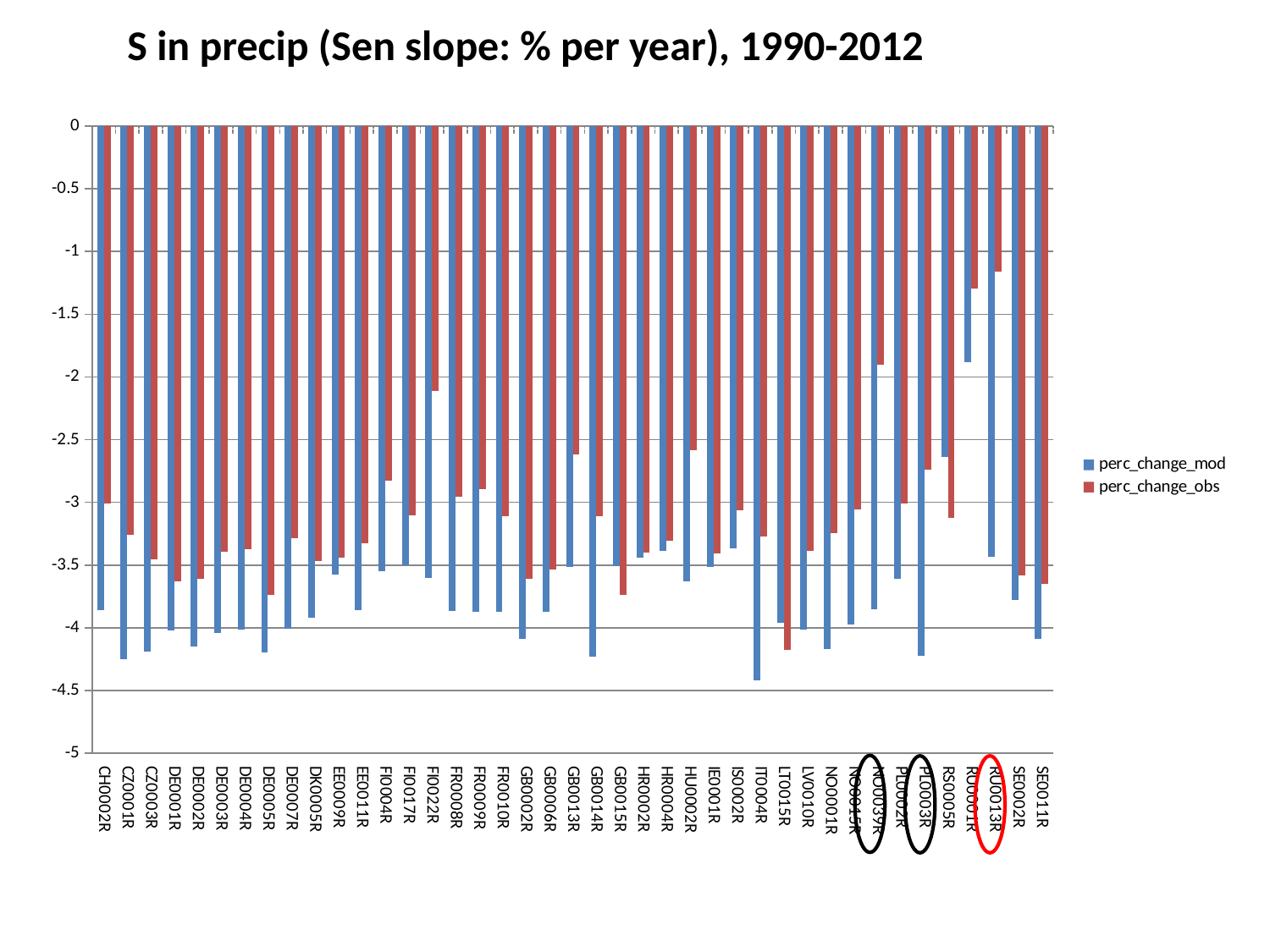
Is the perc_change_mod value for IT0004R greater or less than -4? less What kind of chart is shown on the slide? bar chart For LT0015R, which series has the more negative value, perc_change_mod or perc_change_obs? perc_change_obs Which category has the lowest (most negative) perc_change_mod value? IT0004R Which category has the highest (least negative) perc_change_mod value? RU0001R How many series does the legend list? 2 Which series is drawn in red? perc_change_obs Is the perc_change_obs value for RU0013R greater or less than -1.5? greater Which category has the highest (least negative) perc_change_obs value? RU0013R What is the title of the chart? S in precip (Sen slope: % per year), 1990-2012 For RU0013R, which series has the more negative value, perc_change_mod or perc_change_obs? perc_change_mod Is the perc_change_obs value for FI0022R greater or less than -2.5? greater